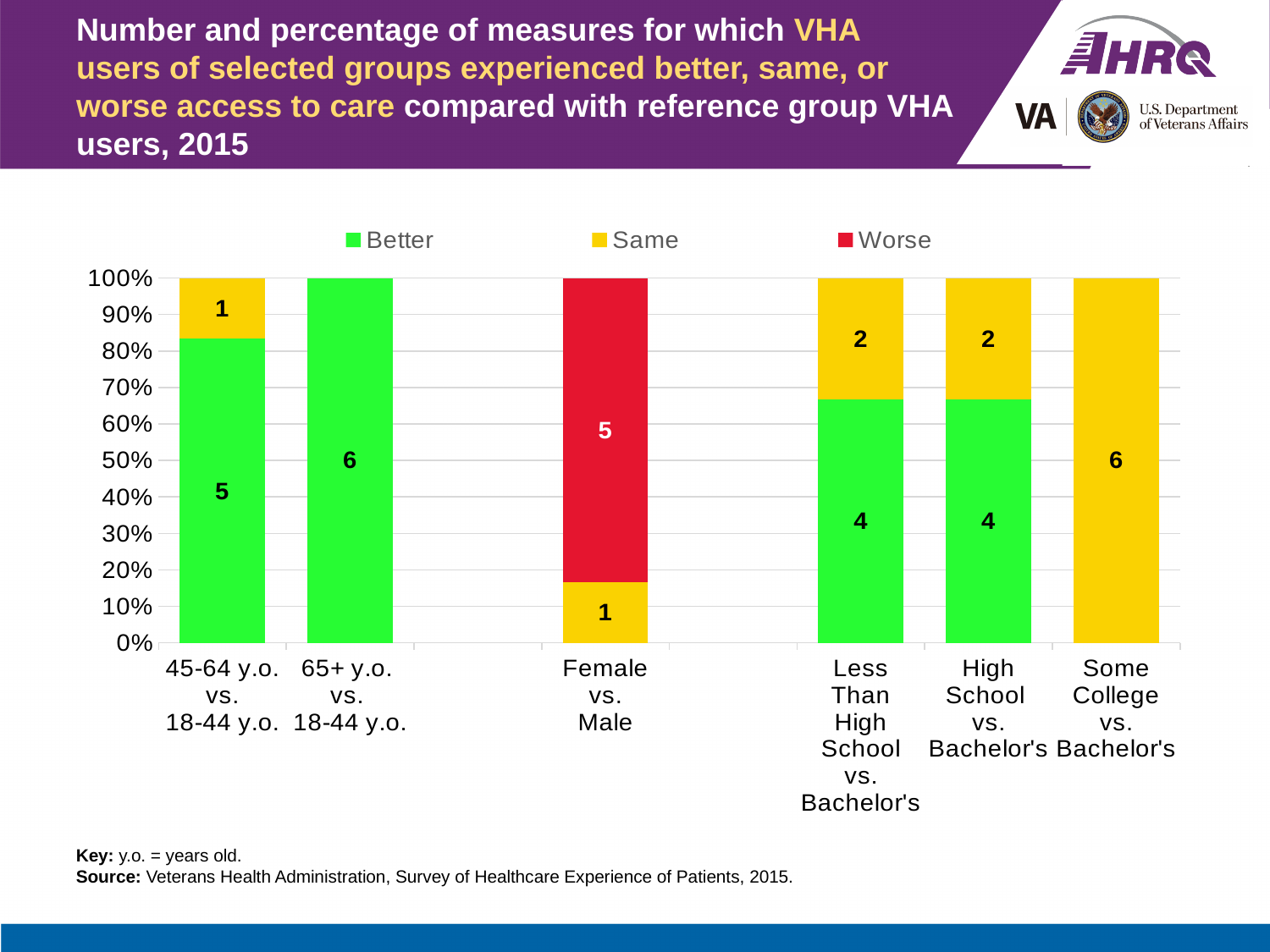
How many measures were 'Better' for 45-64 y.o. vs. 18-44 y.o.? 5 How many measures were 'Same' for Some College vs. Bachelor's? 6 How many measures were 'Better' for 65+ y.o. vs. 18-44 y.o.? 6 How many measures were 'Same' for High School vs. Bachelor's? 2 What is the total number of measures shown for Less Than High School vs. Bachelor's? 6 How many series does the legend list? 3 Is the 'Better' count for 45-64 y.o. vs. 18-44 y.o. larger or smaller than the 'Better' count for High School vs. Bachelor's? larger Which group comparison has the largest 'Worse' count? Female vs. Male What is the difference between the 'Better' and 'Same' counts for Less Than High School vs. Bachelor's? 2 What type of chart is shown on the slide? Stacked bar chart How many group comparisons are shown on the x axis? 6 How many measures were 'Worse' for Female vs. Male? 5